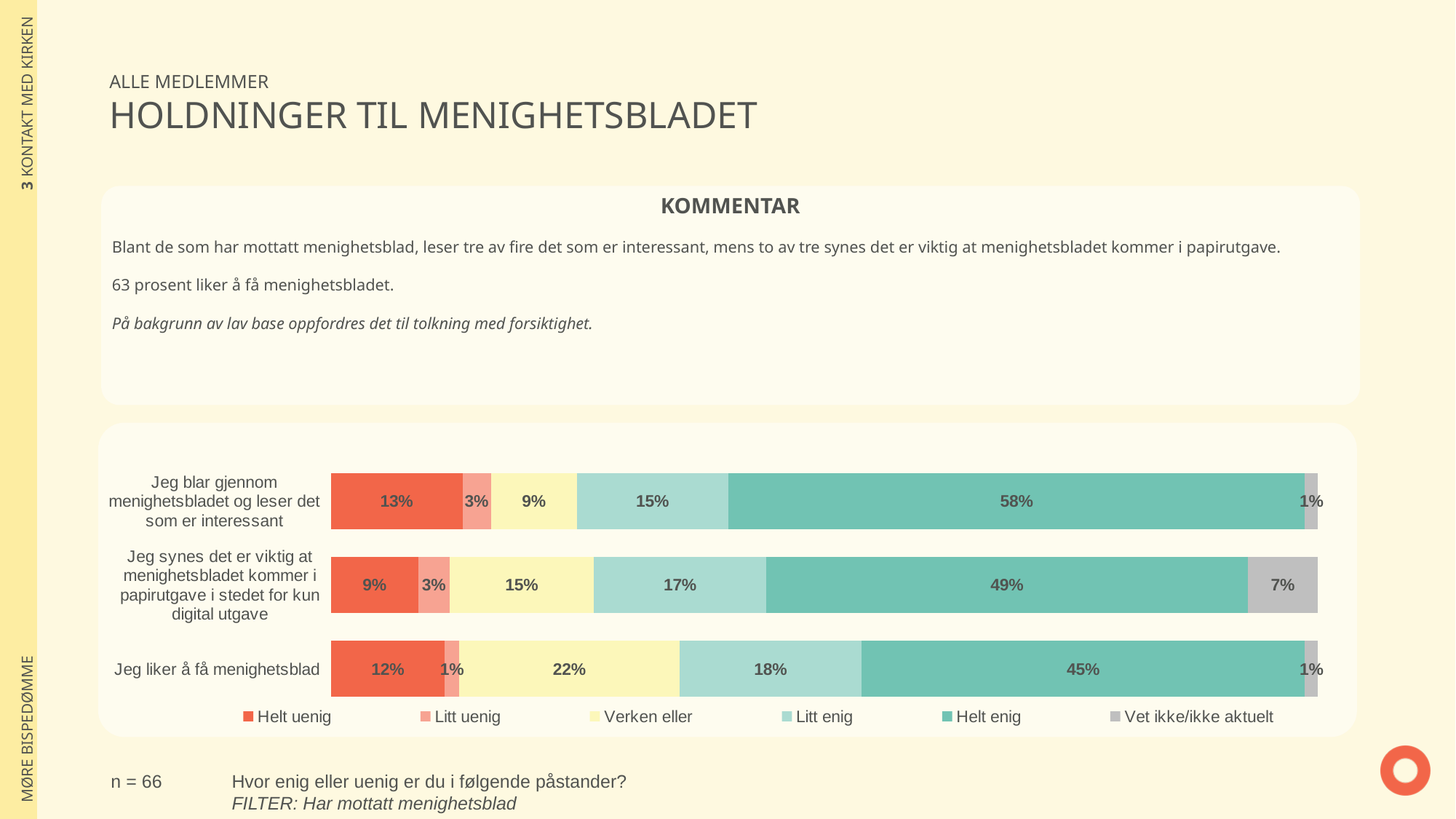
What is the difference between the 'Helt enig' values for 'Jeg blar gjennom menighetsbladet og leser det som er interessant' and 'Jeg liker å få menighetsblad'? 13% What is the 'Helt uenig' value for 'Jeg synes det er viktig at menighetsbladet kommer i papirutgave i stedet for kun digital utgave'? 9% What is the 'Vet ikke/ikke aktuelt' value for 'Jeg synes det er viktig at menighetsbladet kommer i papirutgave i stedet for kun digital utgave'? 7% What is the 'Helt enig' value for 'Jeg blar gjennom menighetsbladet og leser det som er interessant'? 58% What colour represents 'Helt uenig' in the legend? Red/orange What is the 'Verken eller' value for 'Jeg liker å få menighetsblad'? 22% How many statements (categories) are plotted in the chart? 3 Which is larger: the 'Litt enig' value for 'Jeg liker å få menighetsblad' or for 'Jeg synes det er viktig at menighetsbladet kommer i papirutgave i stedet for kun digital utgave'? Jeg liker å få menighetsblad Which statement has the highest 'Helt enig' share? Jeg blar gjennom menighetsbladet og leser det som er interessant How many series does the legend list? 6 What kind of chart is shown on the slide? Stacked bar chart Which statement has the lowest 'Litt uenig' share? Jeg liker å få menighetsblad